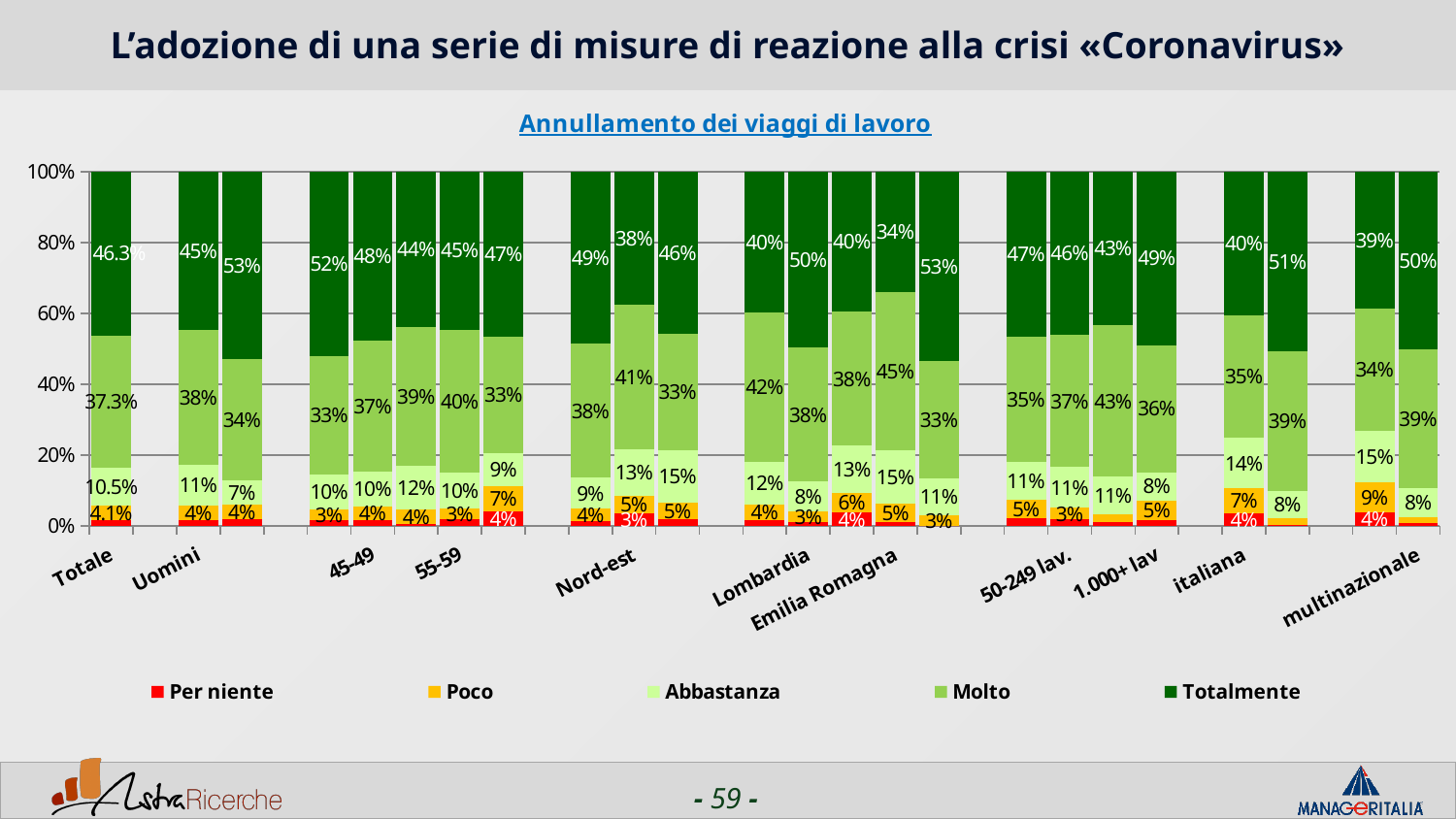
How many series does the legend list? 5 What is the title of the chart? Annullamento dei viaggi di lavoro What kind of chart is shown on the slide? stacked bar chart What is the first entry in the chart legend? Per niente For the 'Totale' bar, which is larger: 'Totalmente' or 'Molto'? Totalmente Is the 'Totalmente' value for 'Totale' greater or less than 40%? greater What is the value of 'Totalmente' for 'Uomini'? 45% What is the value of 'Abbastanza' for 'Uomini'? 11% What is the value of 'Totalmente' for the 'Totale' bar? 46.3% What is the value of 'Molto' for the 'Totale' bar? 37.3% For the 'Totale' bar, what is the difference between 'Totalmente' and 'Molto'? 9 percentage points What is the value of 'Abbastanza' for the 'Totale' bar? 10.5%